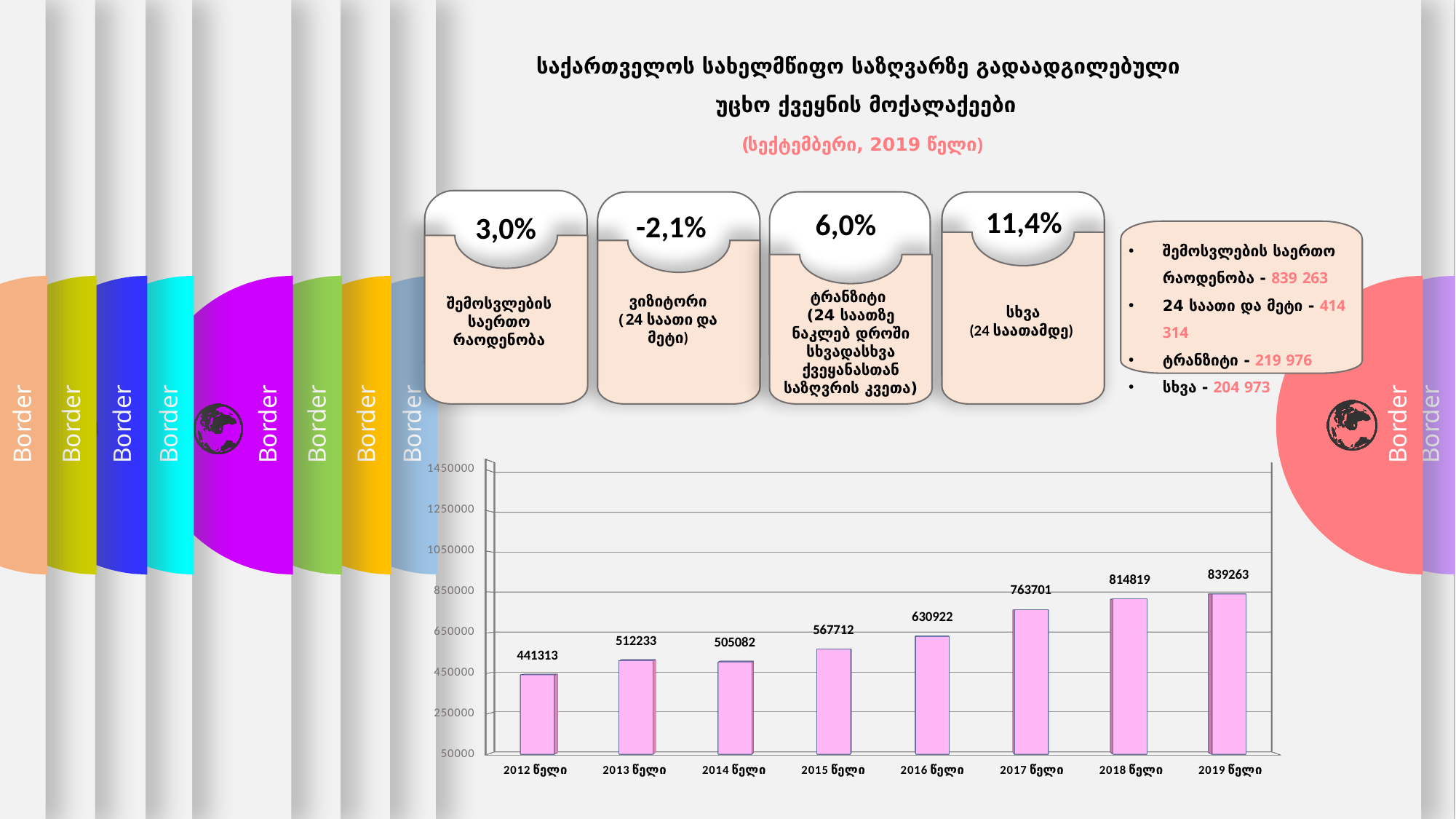
What is the difference between the values for 2017 and 2016 in the bar chart? 132779 What type of chart is shown at the bottom of the slide? bar chart Which year has the lowest value in the bar chart? 2012 წელი What is the value shown for 2016 (2016 წელი) in the bar chart? 630922 How many years (bars) are shown in the bar chart? 8 Which year has the highest value in the bar chart? 2019 წელი Which is larger in the bar chart, the value for 2013 or the value for 2014? 2013 წელი What is the value shown for 2019 (2019 წელი) in the bar chart? 839263 What is the value shown for 2012 (2012 წელი) in the bar chart? 441313 Do the values in the bar chart generally rise or fall from 2012 to 2019? rise Is the value for 2017 in the bar chart greater or less than 650000? greater What is the difference between the values for 2019 and 2018 in the bar chart? 24444